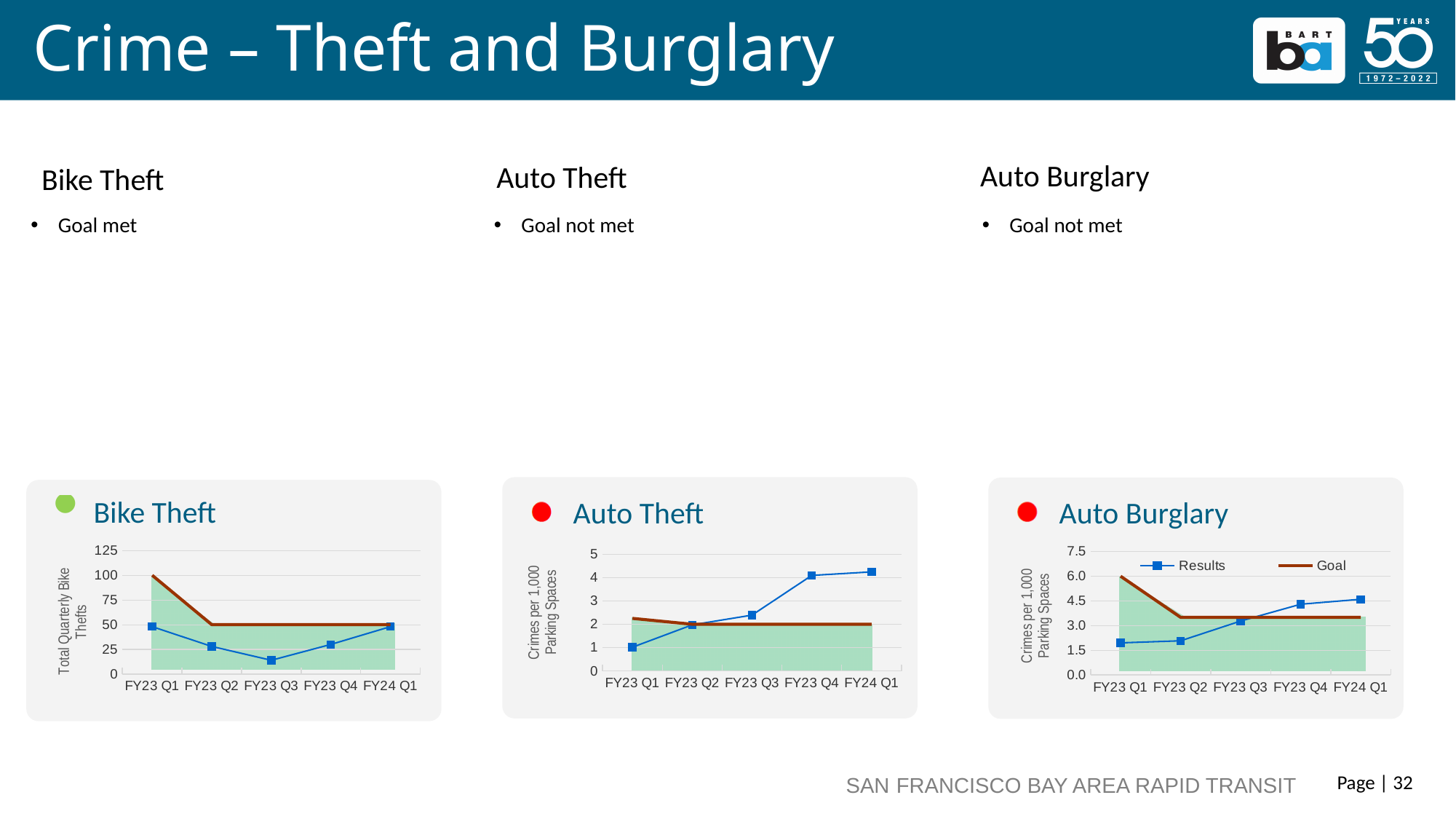
How many series does the legend of the Auto Burglary chart list? 2 On the Bike Theft chart, is the Results value for FY23 Q3 greater or less than 25? less How many quarters are plotted on the x axis of the Bike Theft chart? 5 On the Auto Theft chart, do the Results values generally rise or fall from FY23 Q1 to FY24 Q1? rise On the Bike Theft chart, in which quarter is the Results value lowest? FY23 Q3 On the Auto Theft chart, what is the Goal value for FY24 Q1? 2 On the Auto Burglary chart, which is larger for FY24 Q1, the Results value or the Goal value? Results On the Auto Theft chart, is the Results value for FY24 Q1 greater or less than 4? greater What kind of chart is the Bike Theft chart? line chart On the Bike Theft chart, what is the Goal value for FY23 Q1? 100 What are the two legend entries on the Auto Burglary chart? Results and Goal On the Auto Burglary chart, is the Results value for FY23 Q1 greater or less than 3.0? less